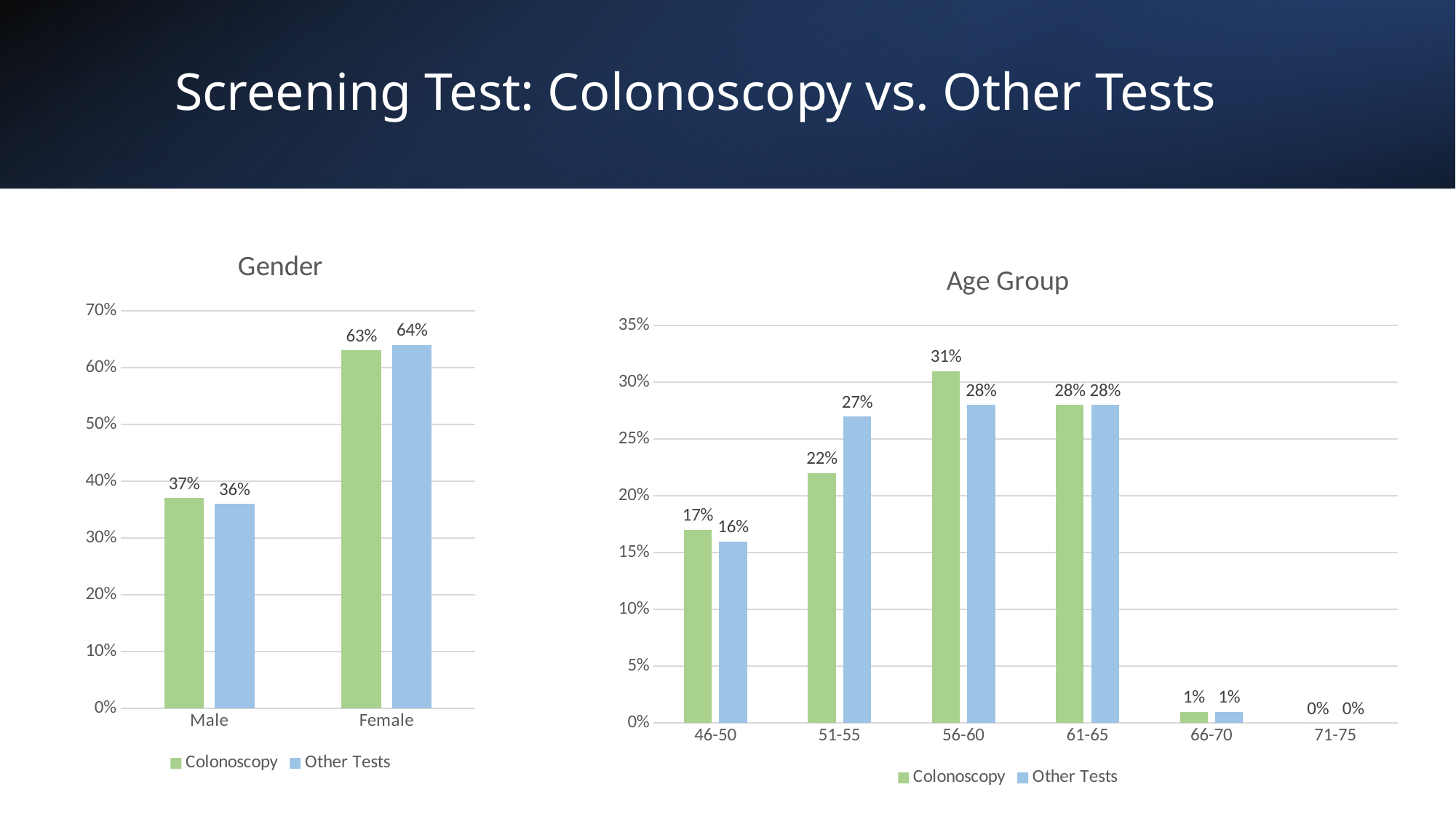
In the Age Group chart, which age group has the lowest Other Tests value? 71-75 In the Gender chart, what is the Colonoscopy value for Male? 37% In the Age Group chart, what is the difference between the Colonoscopy and Other Tests values for the 51-55 age group? 5% In the Gender chart, what is the difference between the Female and Male Colonoscopy values? 26% In the Age Group chart, which age group has the highest Colonoscopy value? 56-60 In the Age Group chart, which is larger for the 46-50 age group: Colonoscopy or Other Tests? Colonoscopy In the Age Group chart, how many age group categories are shown on the x axis? 6 What kind of chart is the Age Group chart? Bar chart In the Gender chart, how many series does the legend list? 2 In the Gender chart, what is the Other Tests value for Female? 64% In the Age Group chart, what is the Other Tests value for the 51-55 age group? 27% In the Age Group chart, what is the Colonoscopy value for the 56-60 age group? 31%